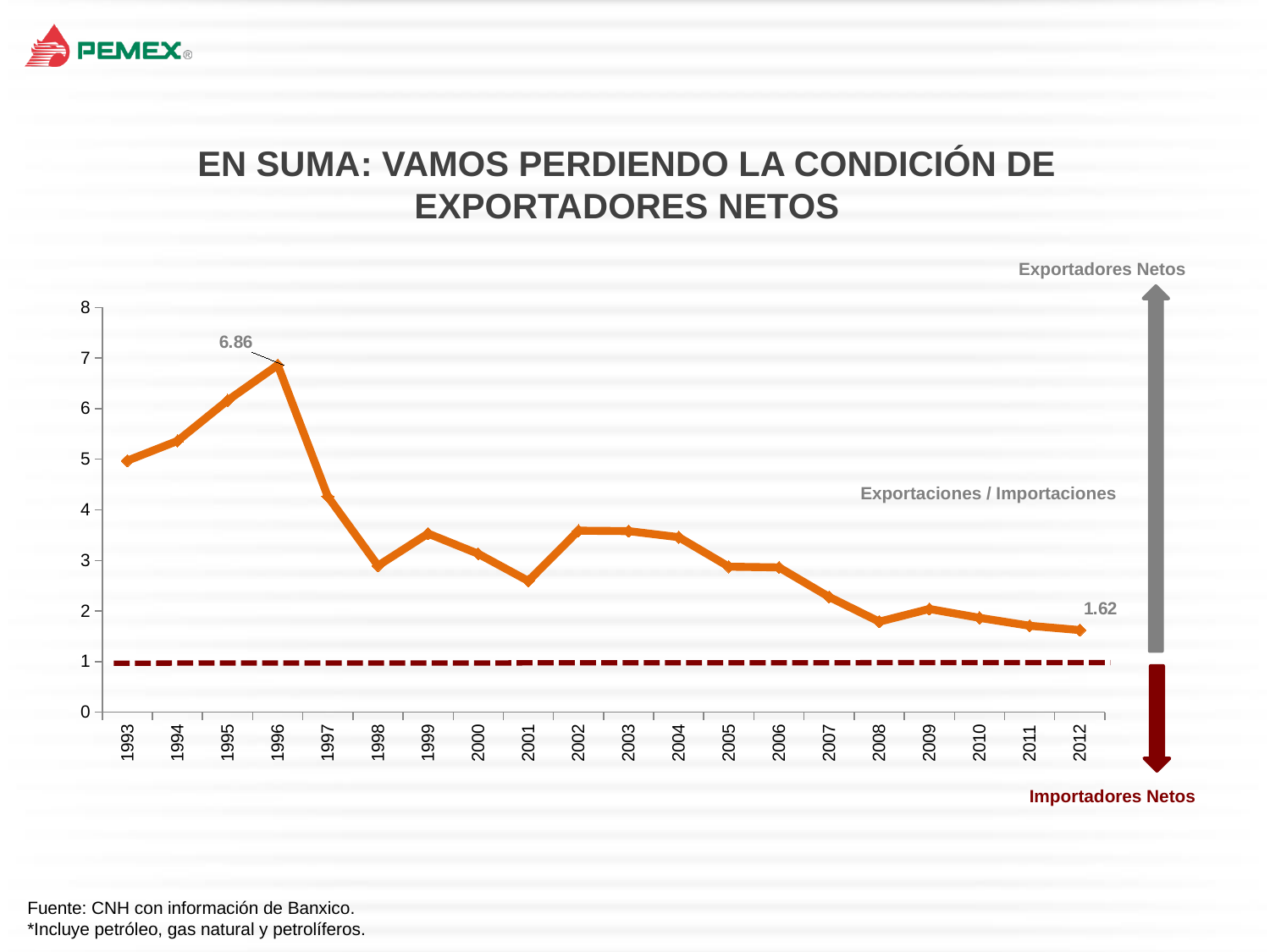
How many years are plotted on the x axis? 20 What is the value of Exportaciones / Importaciones for 2012? 1.62 Does the Exportaciones / Importaciones ratio rise or fall overall from 1996 to 2012? Fall Which year has a larger Exportaciones / Importaciones ratio, 1993 or 1998? 1993 What is the difference between the 1996 value (6.86) and the 2012 value (1.62)? 5.24 What is the value of Exportaciones / Importaciones for 1996? 6.86 What kind of chart is shown on the slide? Line chart Is the value for 1993 greater or less than 4? greater Is the value for 2008 greater or less than 2? less In which year is the Exportaciones / Importaciones ratio lowest? 2012 In which year is the Exportaciones / Importaciones ratio highest? 1996 Is the value for 2001 greater or less than 3? less